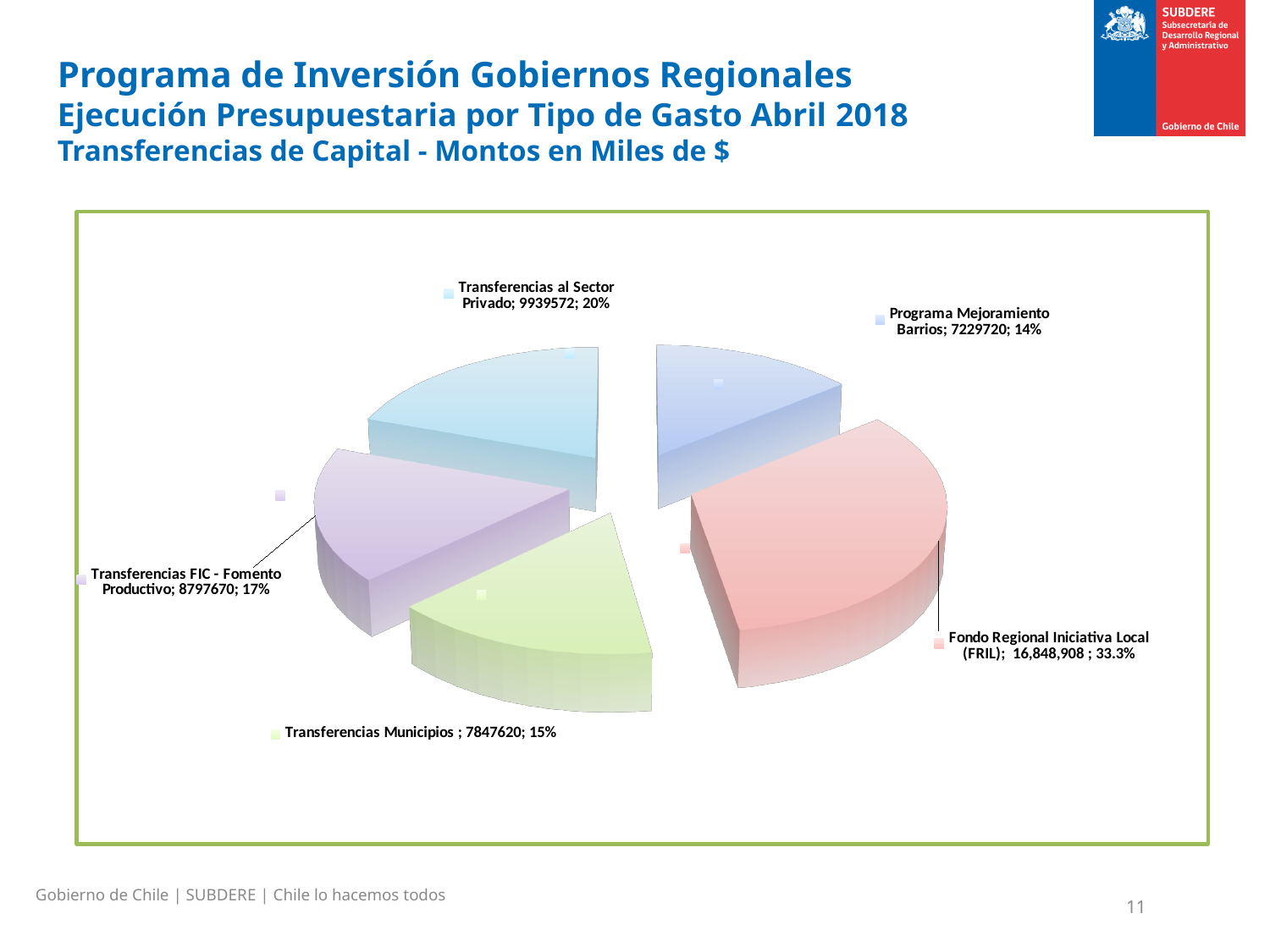
What percentage share does Transferencias FIC - Fomento Productivo have? 17% What kind of chart is shown on the slide? Pie chart Which is larger, Transferencias FIC - Fomento Productivo or Transferencias Municipios? Transferencias FIC - Fomento Productivo How many categories are shown in the pie chart? 5 What value is shown for Programa Mejoramiento Barrios? 7229720 What is the difference between the values for Transferencias Municipios and Programa Mejoramiento Barrios? 617900 What value is shown for Fondo Regional Iniciativa Local (FRIL)? 16,848,908 What value is shown for Transferencias al Sector Privado? 9939572 What is the difference between the values for Transferencias al Sector Privado and Transferencias FIC - Fomento Productivo? 1141902 Which category has the smallest slice of the pie? Programa Mejoramiento Barrios Which category has the largest slice of the pie? Fondo Regional Iniciativa Local (FRIL) What percentage share does Transferencias Municipios have? 15%